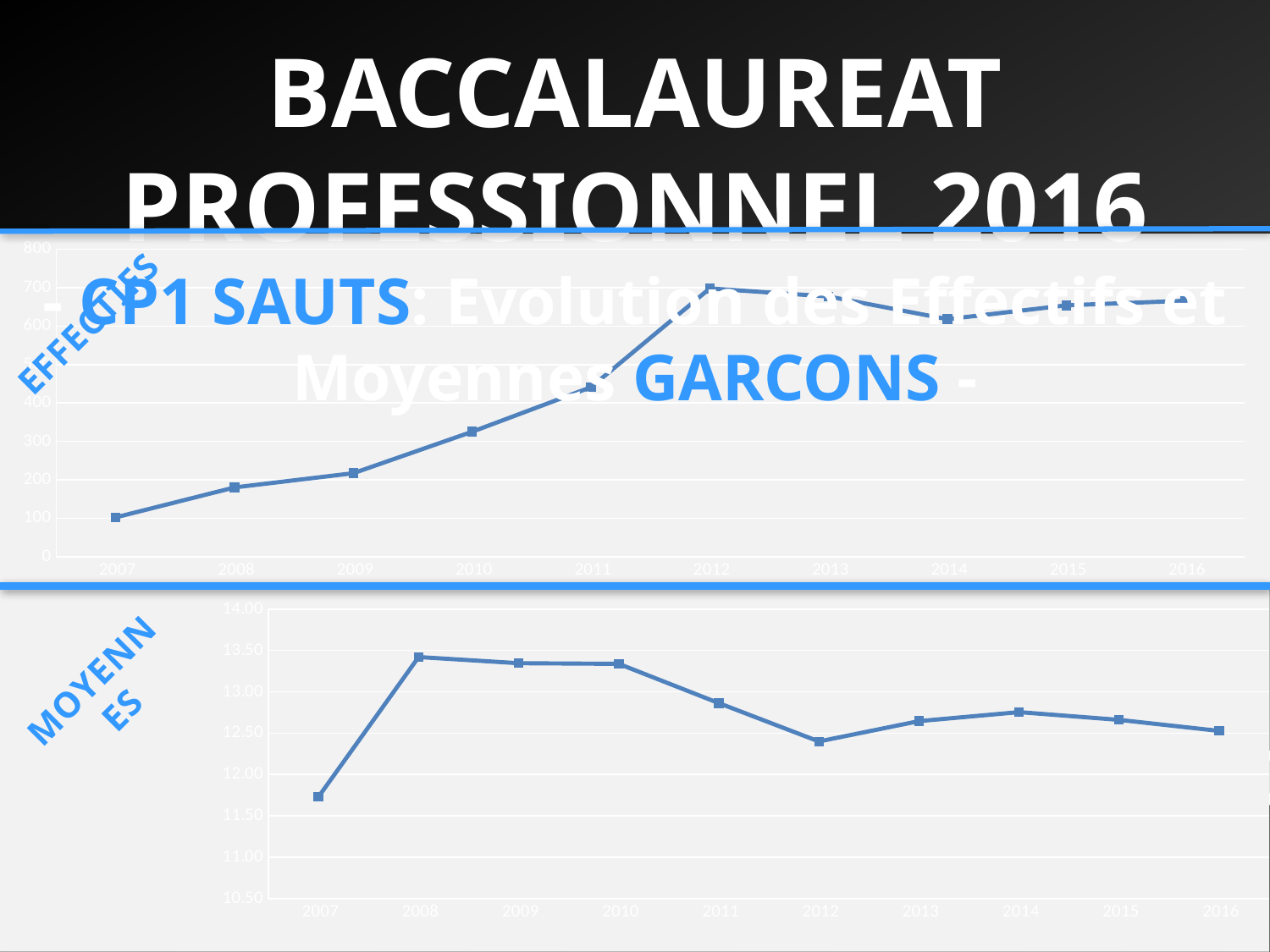
What kind of chart is the top chart (EFFECTIFS)? line chart In the top chart (EFFECTIFS), which year has the lowest value? 2007 In the bottom chart (MOYENNES), is the value for 2012 greater or less than 12.50? less How many years are plotted on the x axis of the top chart (EFFECTIFS)? 10 In the bottom chart (MOYENNES), which year has the highest value? 2008 What kind of chart is the bottom chart (MOYENNES)? line chart In the top chart (EFFECTIFS), which year has the highest value? 2012 In the top chart (EFFECTIFS), is the value for 2011 greater or less than 400? greater In the top chart (EFFECTIFS), which is larger, the value for 2010 or the value for 2014? 2014 In the bottom chart (MOYENNES), which year has the lowest value? 2007 In the top chart (EFFECTIFS), do the values rise or fall from 2007 to 2012? rise In the top chart (EFFECTIFS), is the value for 2009 greater or less than 300? less